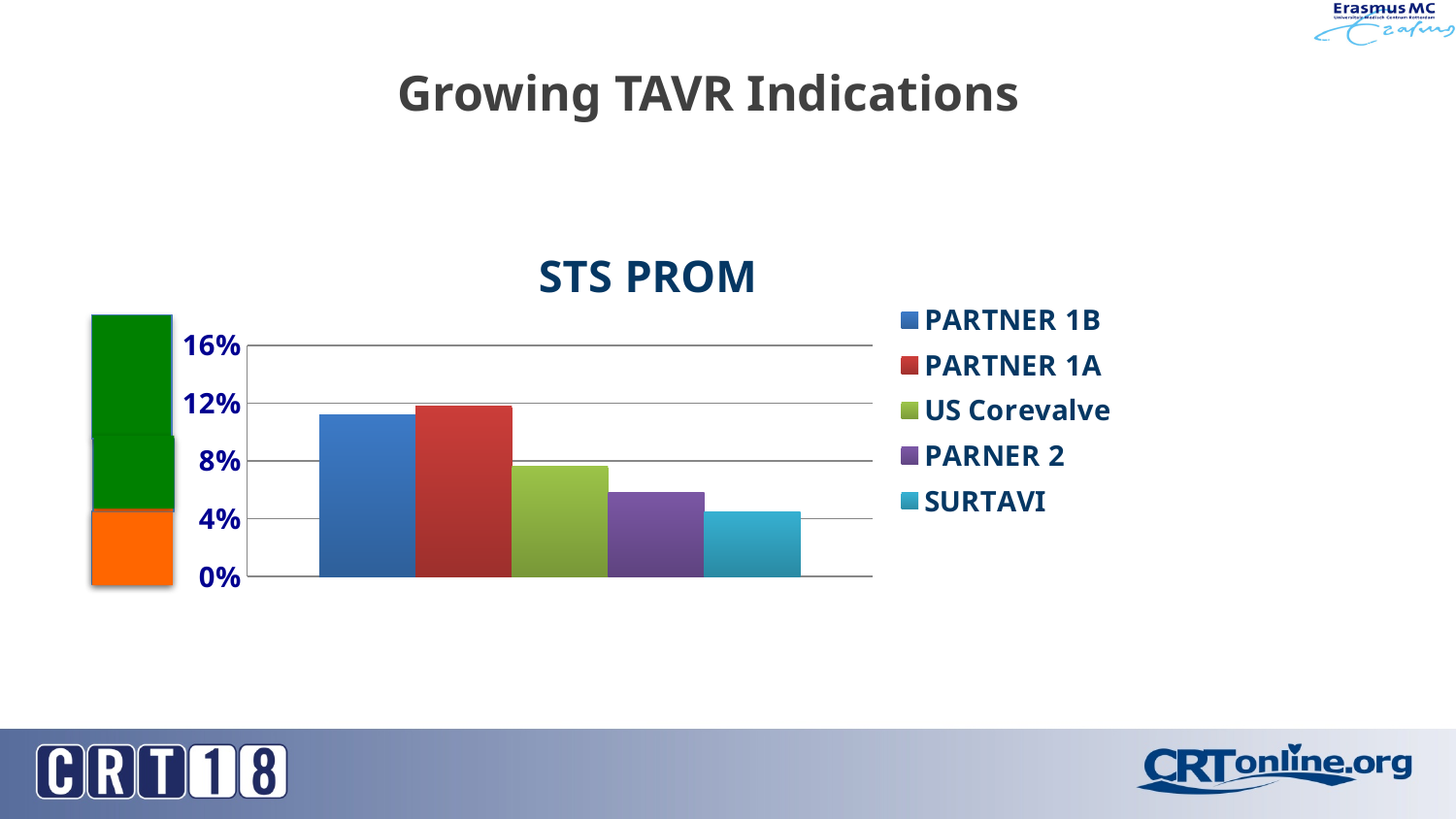
Which is larger, the value for PARTNER 1B or the value for US Corevalve? PARTNER 1B Is the value for PARTNER 1B greater or less than 8%? greater Is the value for PARTNER 1B greater or less than 12%? less What kind of chart is shown under the title STS PROM? bar chart Is the value for US Corevalve greater or less than 8%? less How many series does the legend of the STS PROM chart list? 5 Which is larger, the value for PARNER 2 or the value for SURTAVI? PARNER 2 Which series has the lowest value in the STS PROM chart? SURTAVI What is the title of the chart on the slide? STS PROM